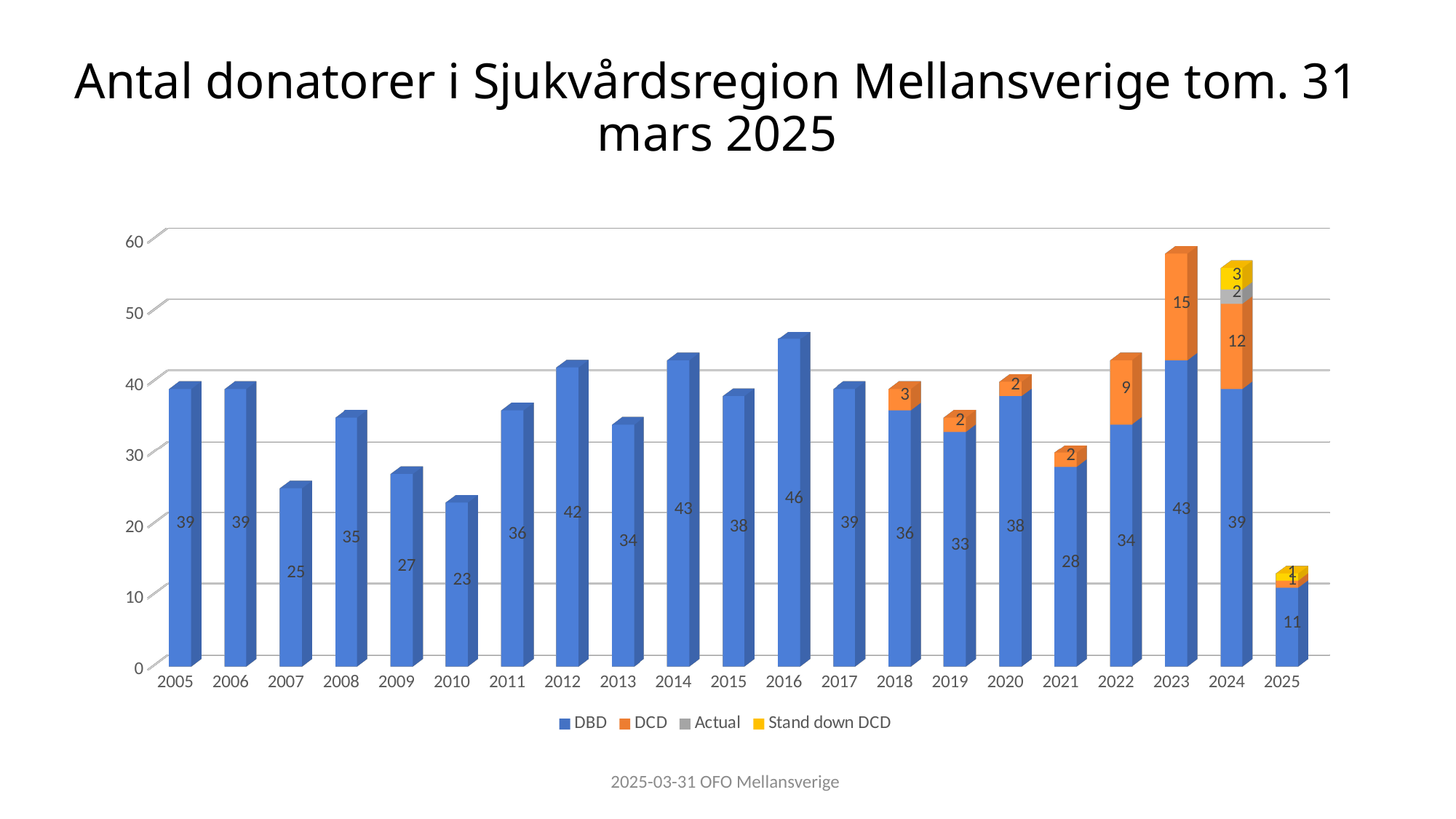
How many series does the legend list? 4 What kind of chart is shown on the slide? stacked bar chart What is the Actual value for 2024? 2 What is the difference between the DBD values for 2014 and 2010? 20 What is the DBD value for 2016? 46 How many years are shown on the x axis? 21 What is the DCD value for 2023? 15 Which year has the highest DBD value? 2016 What is the total of the stacked bar for 2023? 58 Is the DBD value for 2007 greater or less than 30? less Which year has the larger DBD value, 2012 or 2013? 2012 Which year has the lowest DBD value? 2025